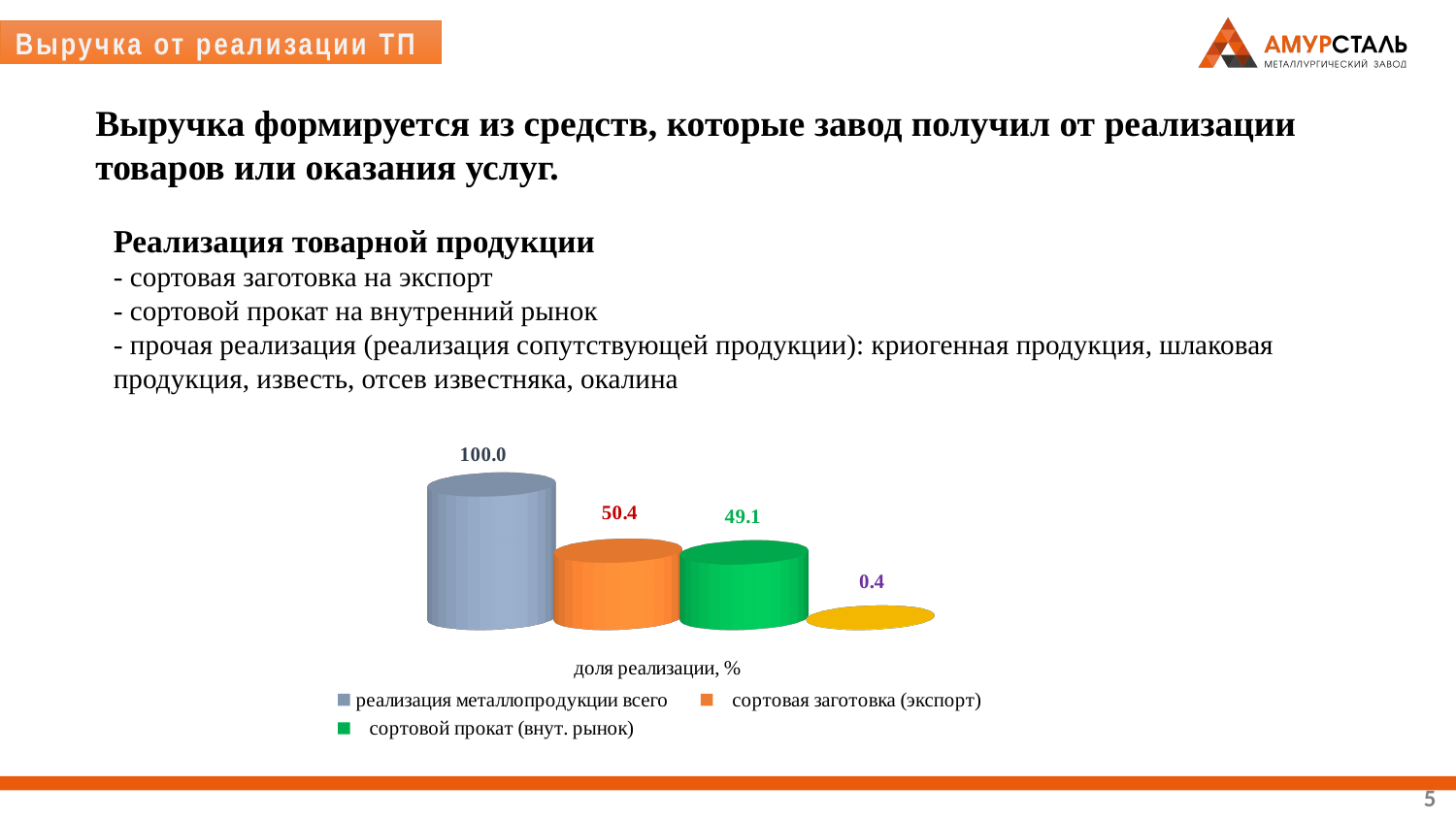
What value is labelled on the yellow bar? 0.4 Which is larger: 'сортовая заготовка (экспорт)' or 'сортовой прокат (внут. рынок)'? сортовая заготовка (экспорт) Which series has the highest value in the chart? реализация металлопродукции всего How many bars are plotted in the chart? 4 What is the difference between 'реализация металлопродукции всего' and 'сортовая заготовка (экспорт)'? 49.6 What value is shown for 'реализация металлопродукции всего'? 100.0 Which bar has the lowest value in the chart? the yellow bar (0.4) What value is shown for 'сортовая заготовка (экспорт)'? 50.4 What kind of chart is shown on the slide? bar chart How many series does the legend list? 3 What value is shown for 'сортовой прокат (внут. рынок)'? 49.1 What is the difference between 'сортовая заготовка (экспорт)' and 'сортовой прокат (внут. рынок)'? 1.3